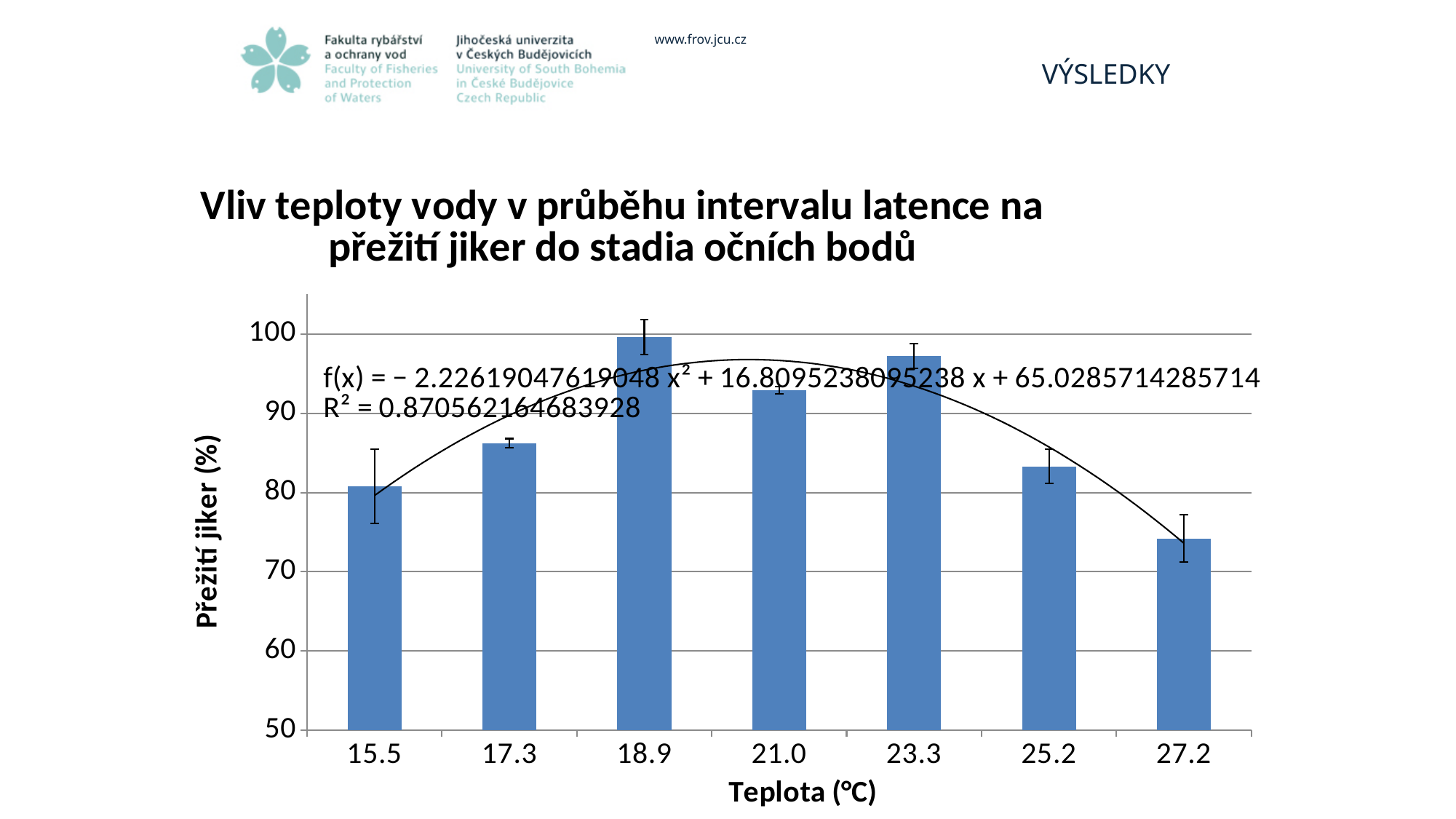
Which temperature has the highest egg survival? 18.9 Which has the higher survival, 15.5 or 27.2? 15.5 Which has the higher survival, 21.0 or 23.3? 23.3 Is the value for 15.5 greater or less than 90? less Is the value for 27.2 greater or less than 80? less What kind of chart is shown on the slide? bar chart Is the value for 23.3 greater or less than 90? greater Which temperature has the lowest egg survival? 27.2 What is the label of the x axis? Teplota (°C) How many temperature categories are plotted on the x axis? 7